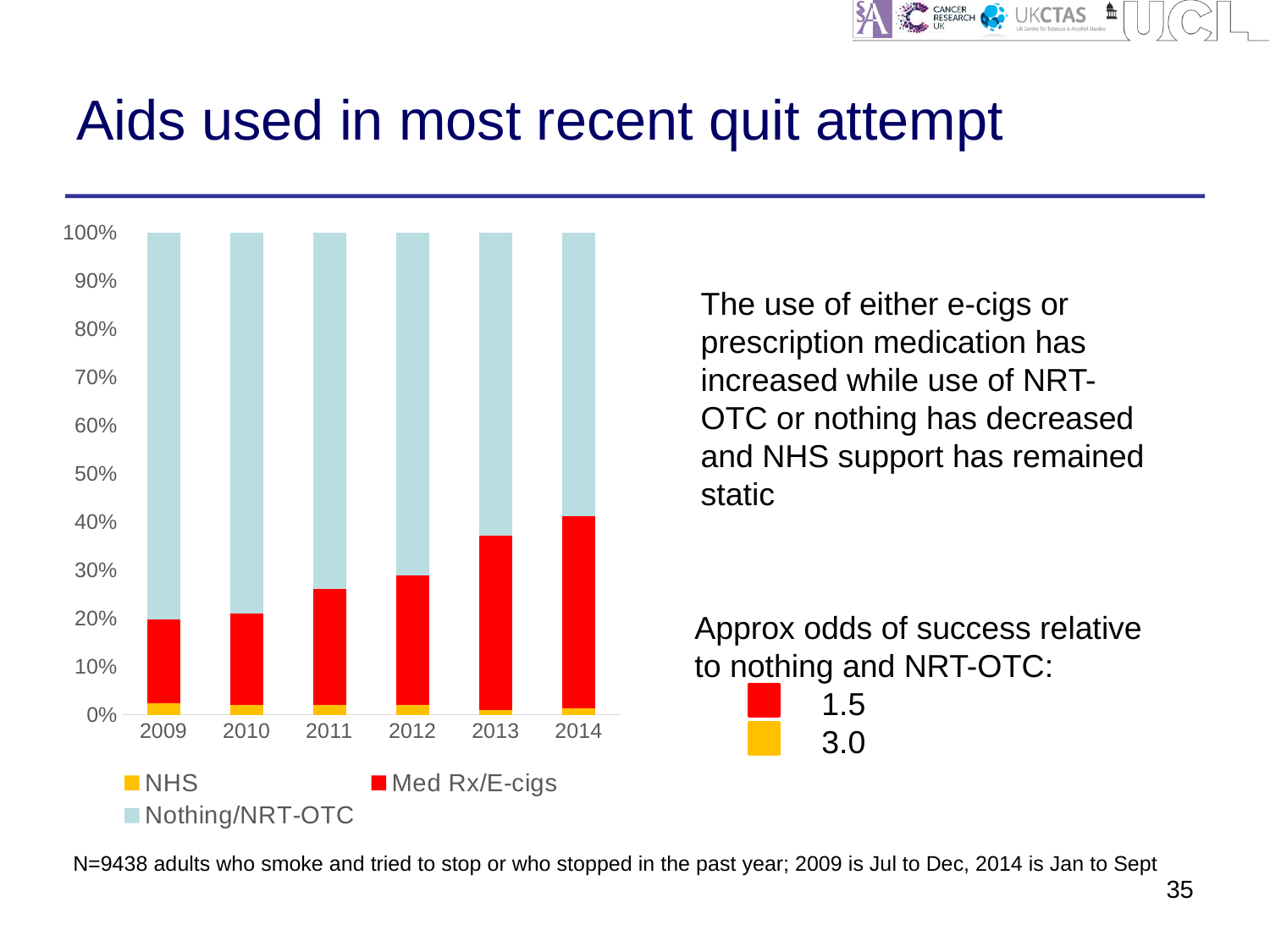
How many series does the chart legend list? 3 What kind of chart is shown on the slide? Stacked bar chart Does the Nothing/NRT-OTC share rise or fall from 2009 to 2014? Fall How many years are shown along the x axis of the chart? 6 Is the Nothing/NRT-OTC share in 2014 greater or less than 70%? less What colour represents the NHS series in the chart? Yellow Which year has the largest Nothing/NRT-OTC share? 2009 Is the Med Rx/E-cigs share in 2009 greater or less than 30%? less Which year has the smallest Med Rx/E-cigs share? 2009 Which year has the largest Med Rx/E-cigs share? 2014 Does the Med Rx/E-cigs share rise or fall from 2009 to 2014? Rise Is the Nothing/NRT-OTC share in 2009 greater or less than 70%? greater